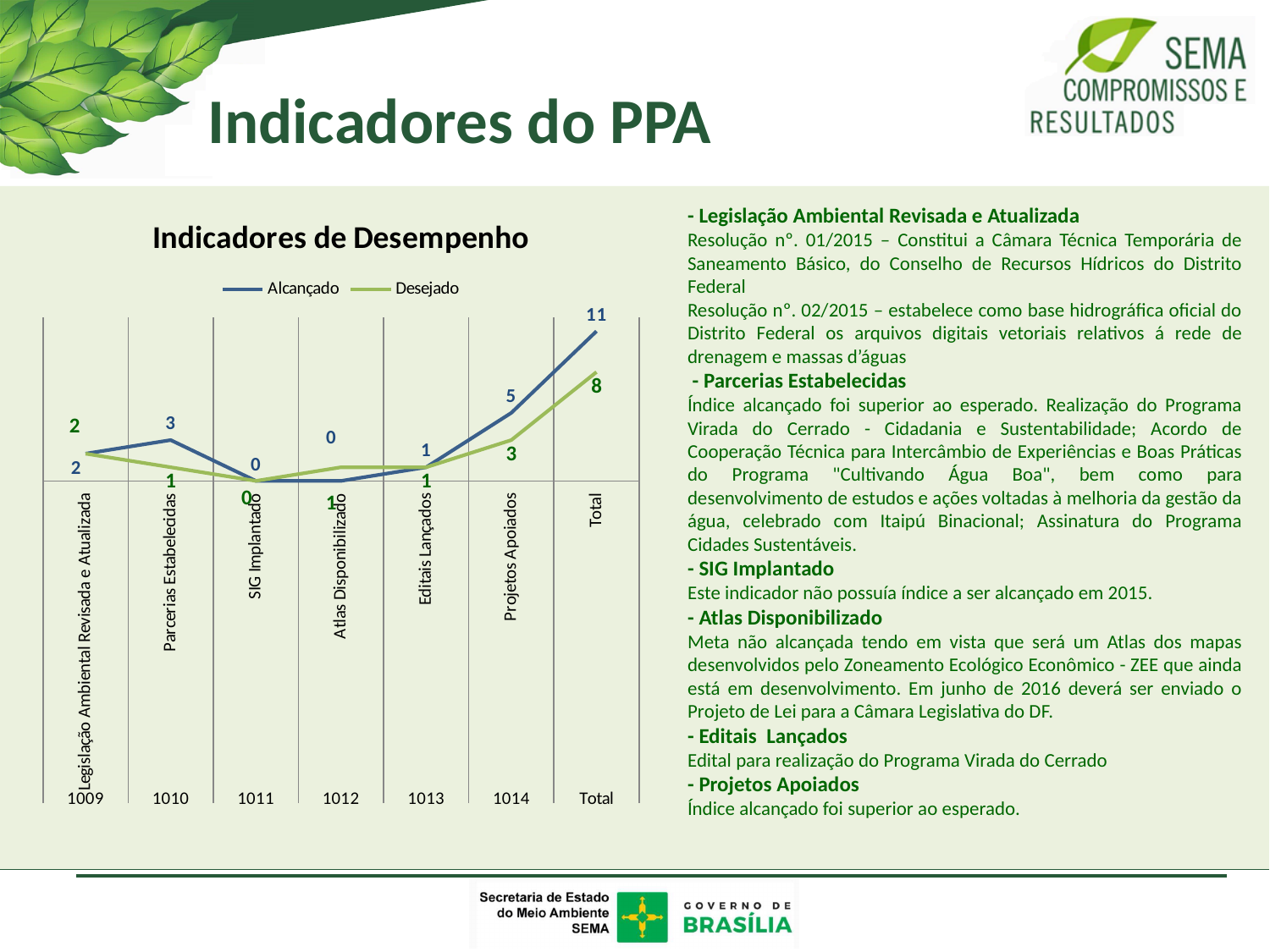
What kind of chart is shown on the slide? line chart How many series does the chart legend list? 2 What is the Alcançado value for Parcerias Estabelecidas? 3 What are the two series named in the chart legend? Alcançado and Desejado What is the difference between the Alcançado and Desejado values for Total? 3 What is the Desejado value for Projetos Apoiados? 3 Excluding Total, which indicator has the highest Alcançado value? Projetos Apoiados What is the Alcançado value for Projetos Apoiados? 5 What is the Desejado value for Atlas Disponibilizado? 1 What is the title of the chart? Indicadores de Desempenho What is the Alcançado value for Total? 11 For Parcerias Estabelecidas, which is larger, the Alcançado value or the Desejado value? Alcançado